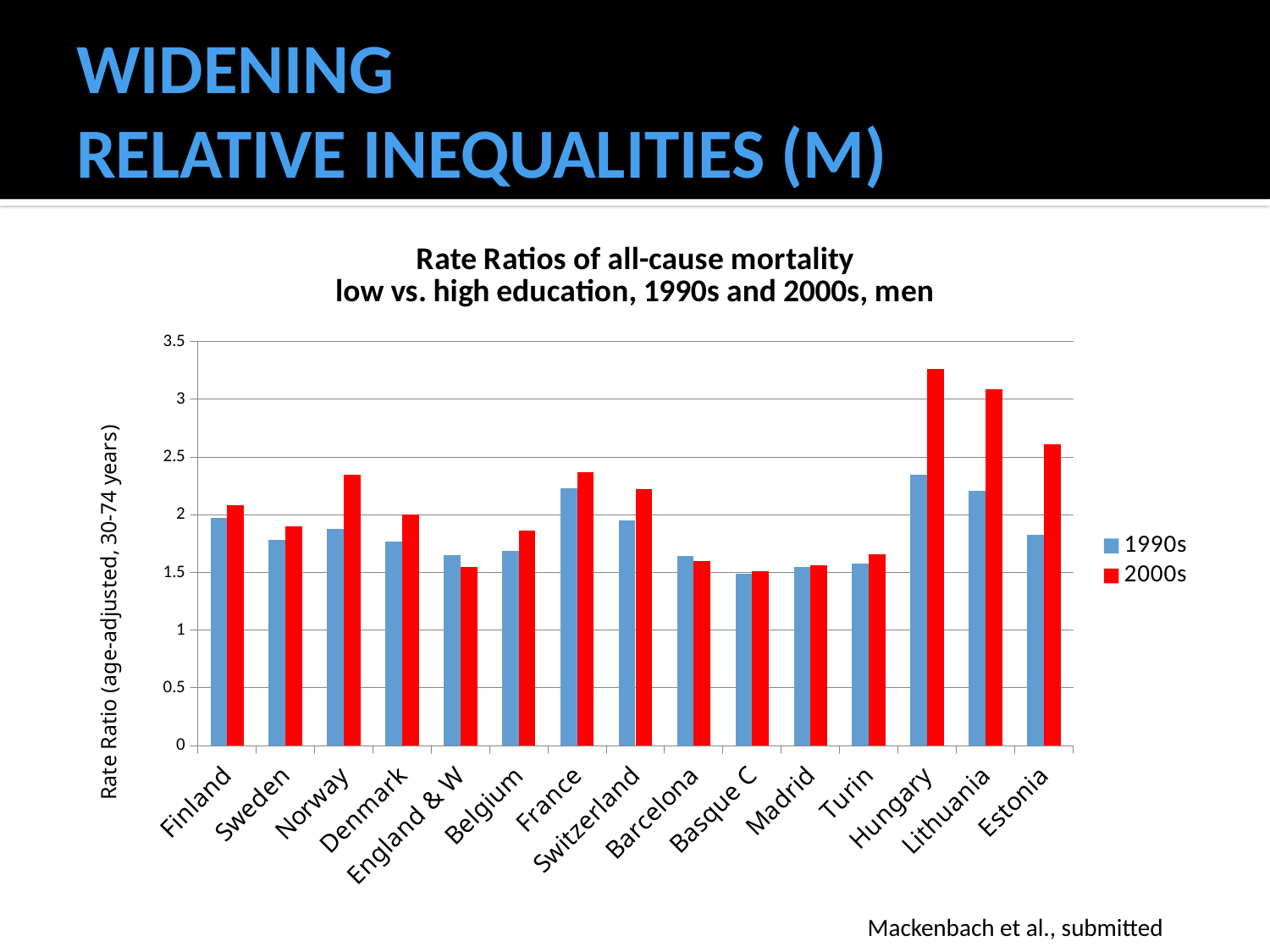
Is the 2000s rate ratio for Norway greater or less than 2? greater Which country or region has the highest rate ratio for the 1990s? Hungary What is the label on the vertical axis of the chart? Rate Ratio (age-adjusted, 30-74 years) Is the 1990s rate ratio for Sweden greater or less than 2? less Is the 2000s rate ratio for Estonia greater or less than 2? greater For England & W, which is larger, the 1990s or the 2000s rate ratio? 1990s What kind of chart is shown on the slide? bar chart How many series does the legend list? 2 For the 2000s, which is larger, the rate ratio for Norway or for Denmark? Norway How many countries or regions are shown on the x axis? 15 Which country or region has the highest rate ratio for the 2000s? Hungary